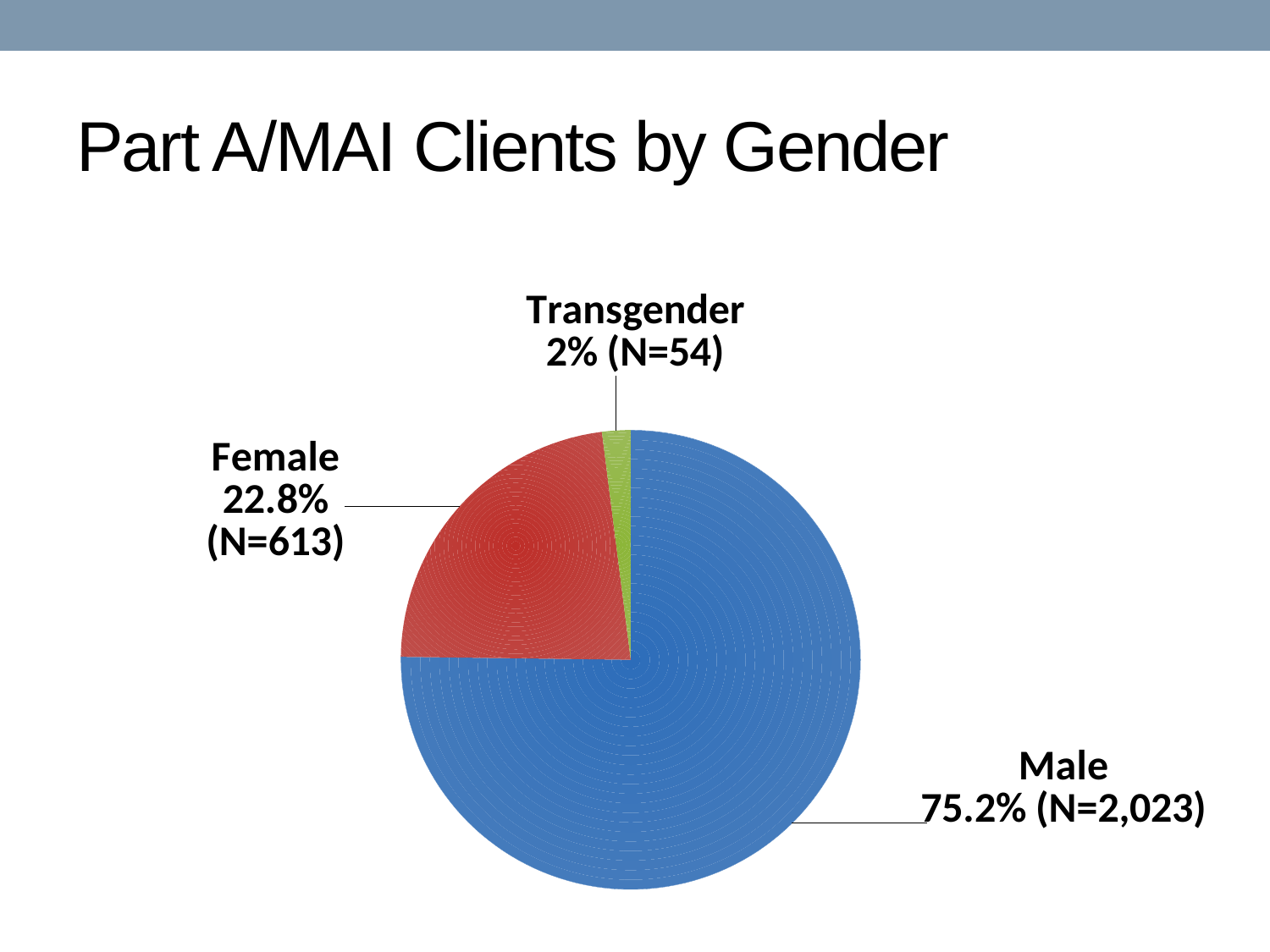
What is the difference in percentage points between the Male and Female shares? 52.4 Which gender category has the largest share of the pie? Male What percentage of Part A/MAI clients are Female? 22.8% How many gender categories are shown in the pie chart? 3 How many Female clients (N) are shown on the chart? 613 What percentage of Part A/MAI clients are Transgender? 2% What percentage of Part A/MAI clients are Male? 75.2% How many Male clients (N) are shown on the chart? 2,023 How many Transgender clients (N) are shown on the chart? 54 What is the title of the slide containing the pie chart? Part A/MAI Clients by Gender What kind of chart is shown on the slide? pie chart Which gender category has the smallest share of the pie? Transgender